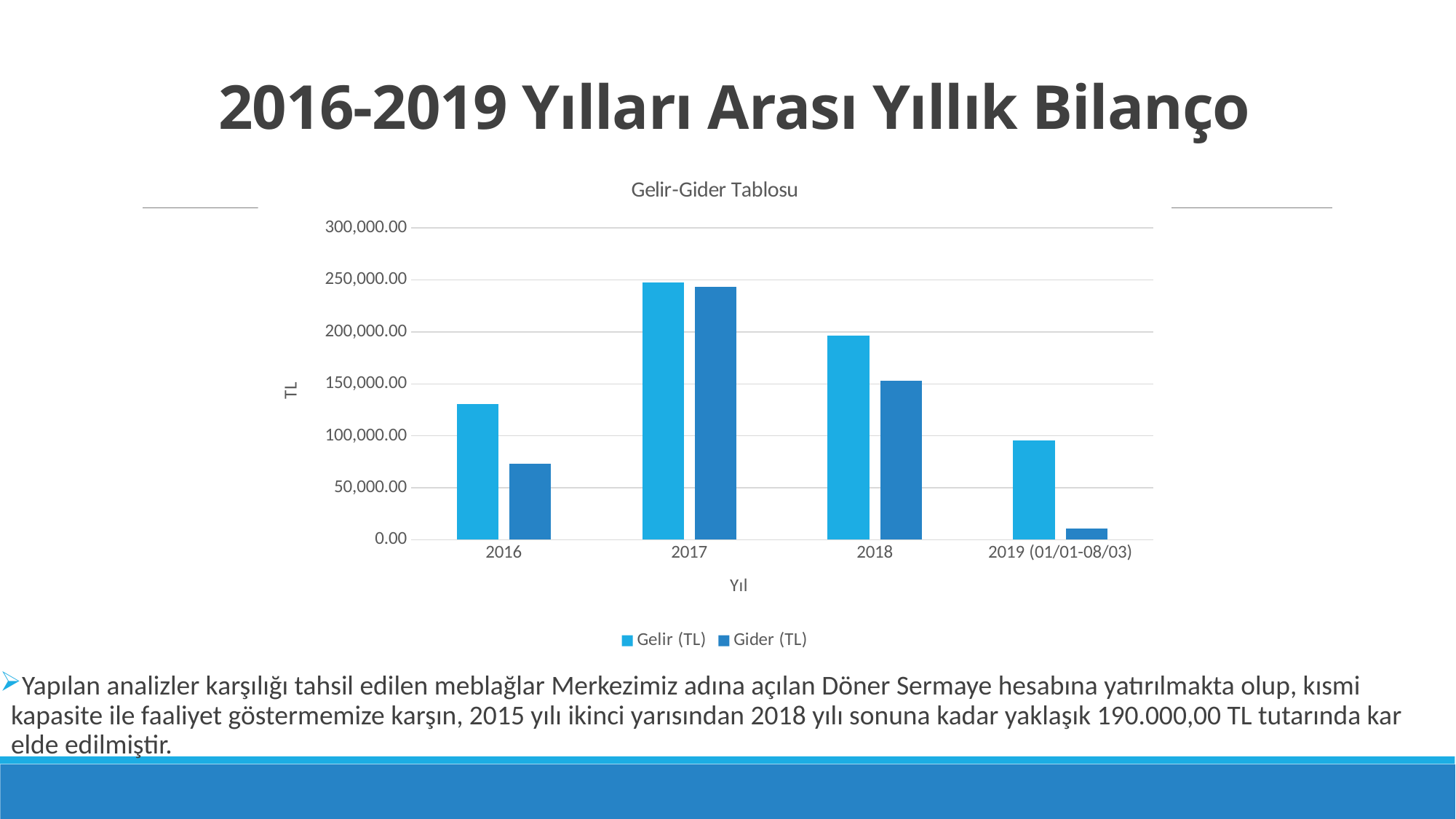
How many series does the legend list? 2 What kind of chart is shown on the slide? bar chart Is the Gelir (TL) value for 2016 greater or less than 100,000.00? greater Which year has the highest Gelir (TL) value? 2017 Which category has the lowest Gelir (TL) value? 2019 (01/01-08/03) Is the Gider (TL) value for 2016 greater or less than 100,000.00? less Is the Gider (TL) value for 2019 (01/01-08/03) greater or less than 50,000.00? less Which year has the highest Gider (TL) value? 2017 Which category has the lowest Gider (TL) value? 2019 (01/01-08/03) How many year categories are shown on the x axis? 4 What is the title of the chart? Gelir-Gider Tablosu In 2018, which is larger, Gelir (TL) or Gider (TL)? Gelir (TL)